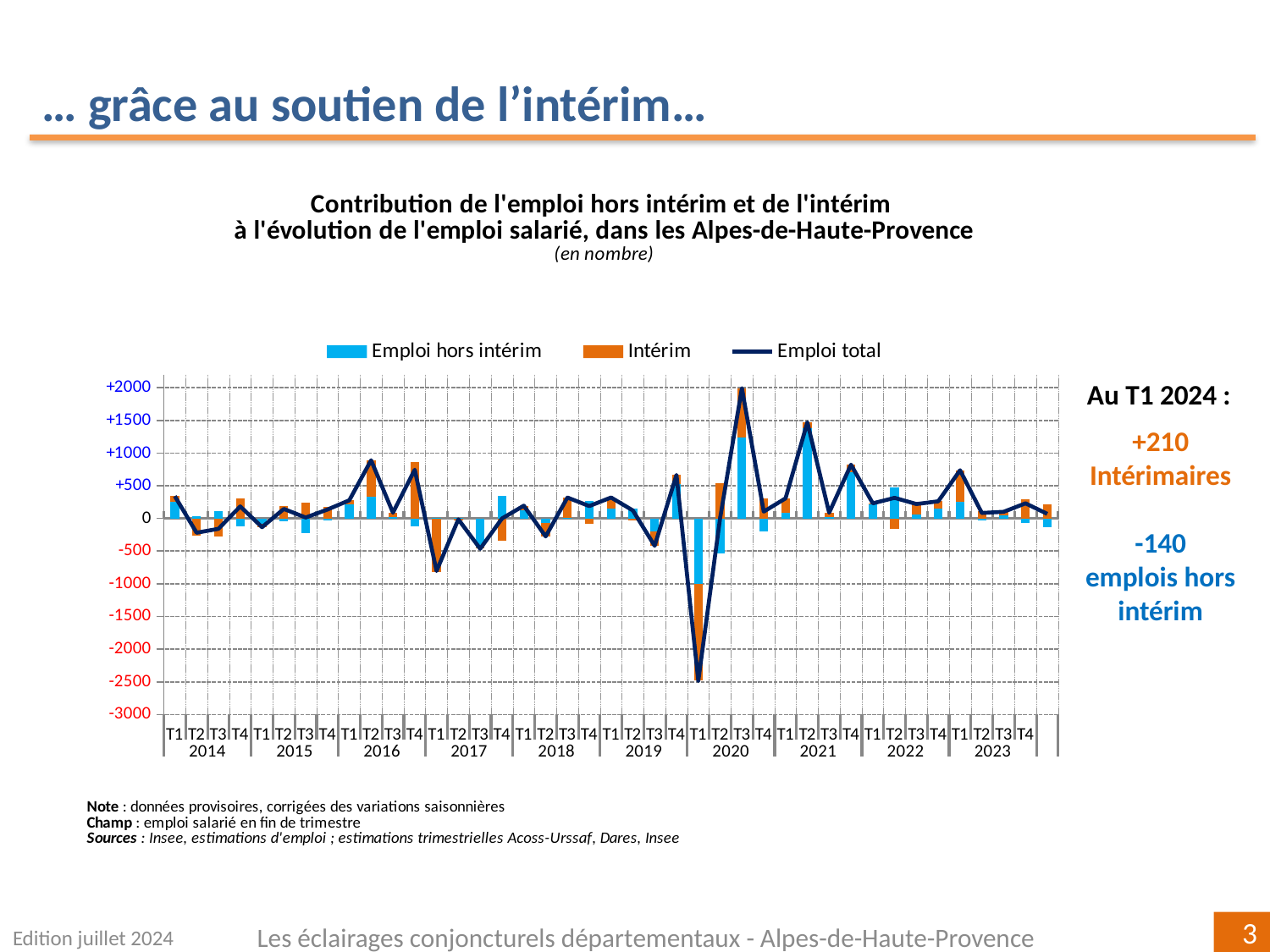
Which series is drawn as a line rather than bars? Emploi total According to the annotation, what is the value for emplois hors intérim at T1 2024? -140 What kind of chart is shown on the slide? A bar chart combined with a line chart In which quarter does the Emploi total line reach its lowest point? T1 2020 Which is larger, the Emploi total value at T3 2020 or at T2 2021? T3 2020 What colour are the bars for the Intérim series? Orange How many years are labelled on the x axis? 10 According to the annotation, what is the value for Intérimaires at T1 2024? +210 Is the Emploi total value at T1 2020 greater or less than -2000? less In which quarter does the Emploi total line reach its highest point? T3 2020 How many series does the legend list? 3 Is the Emploi total value at T3 2020 greater or less than 1500? greater